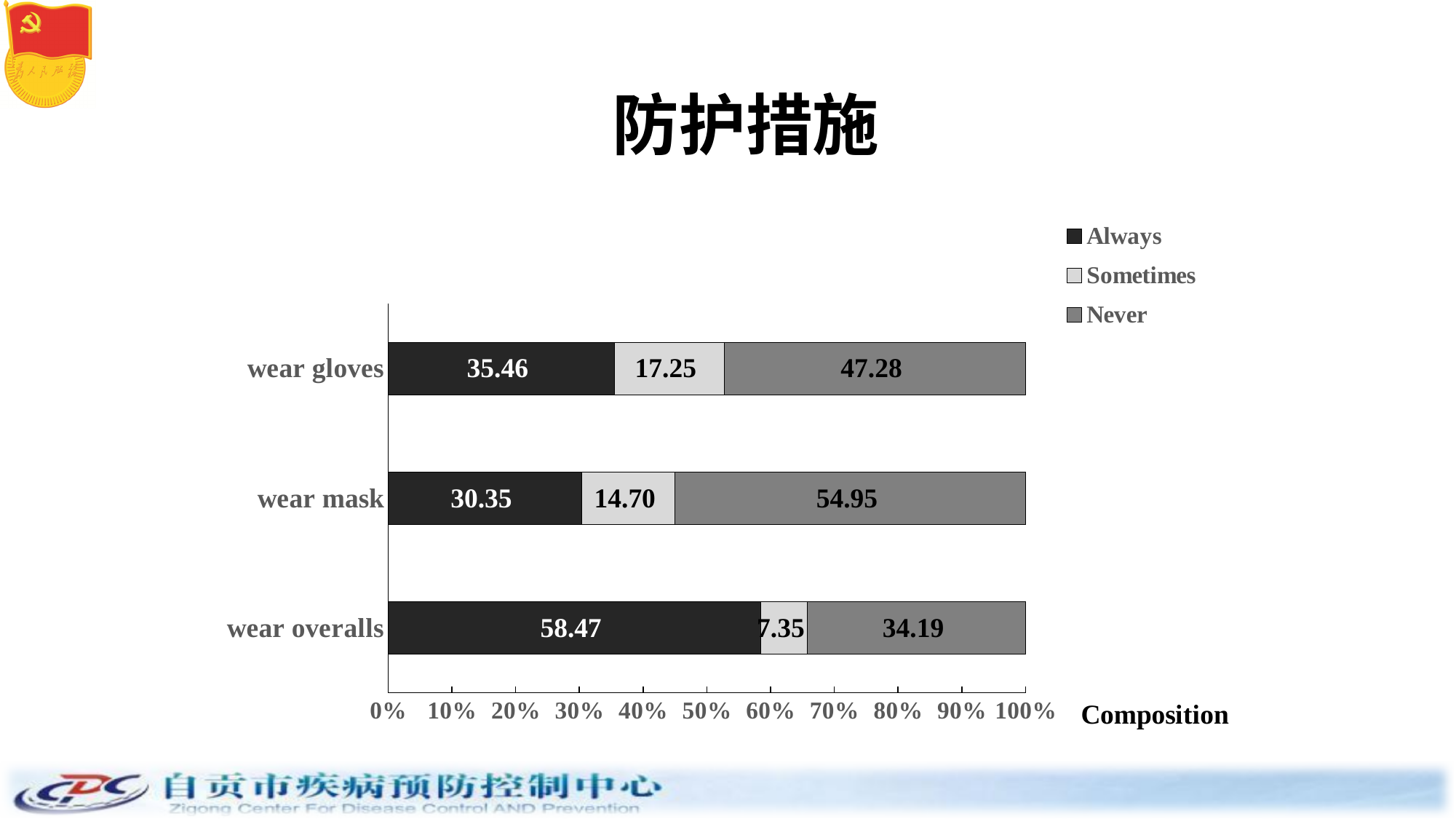
What kind of chart is shown on the slide? stacked bar chart Which category has the highest Never value? wear mask Which category has the highest Always value? wear overalls How many series does the legend list? 3 What is the difference between the Never value for wear mask and the Never value for wear gloves? 7.67 What is the value of the Sometimes series for wear overalls? 7.35 Which category has the lowest Sometimes value? wear overalls How many categories are shown on the chart? 3 What is the difference between the Always value for wear overalls and the Always value for wear gloves? 23.01 What is the value of the Always series for wear gloves? 35.46 What is the value of the Never series for wear mask? 54.95 Which is larger: the Sometimes value for wear gloves or the Sometimes value for wear mask? wear gloves